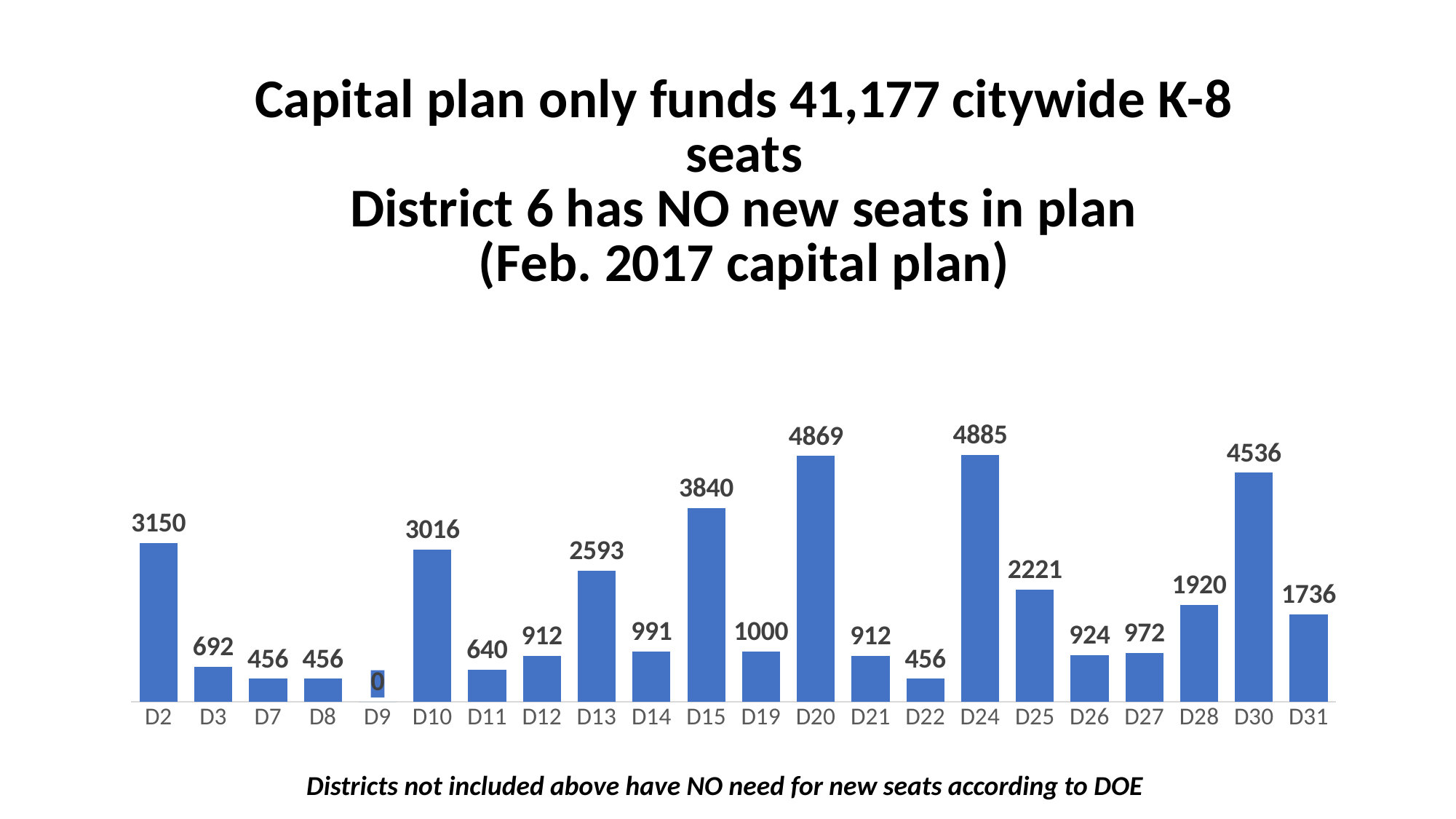
Which district has the lowest value? D9 What is the difference between the values for D20 and D15? 1029 What kind of chart is shown on the slide? Bar chart How many districts are shown on the x axis? 22 Which is larger, the value for D30 or the value for D13? D30 Which districts share the value 456? D7, D8, D22 Which district has the highest value? D24 What value is shown for D9? 0 What value is shown for D28? 1920 According to the note below the chart, what do districts not included in the chart have? NO need for new seats according to DOE What value is shown for D15? 3840 What is the difference between the values for D2 and D10? 134